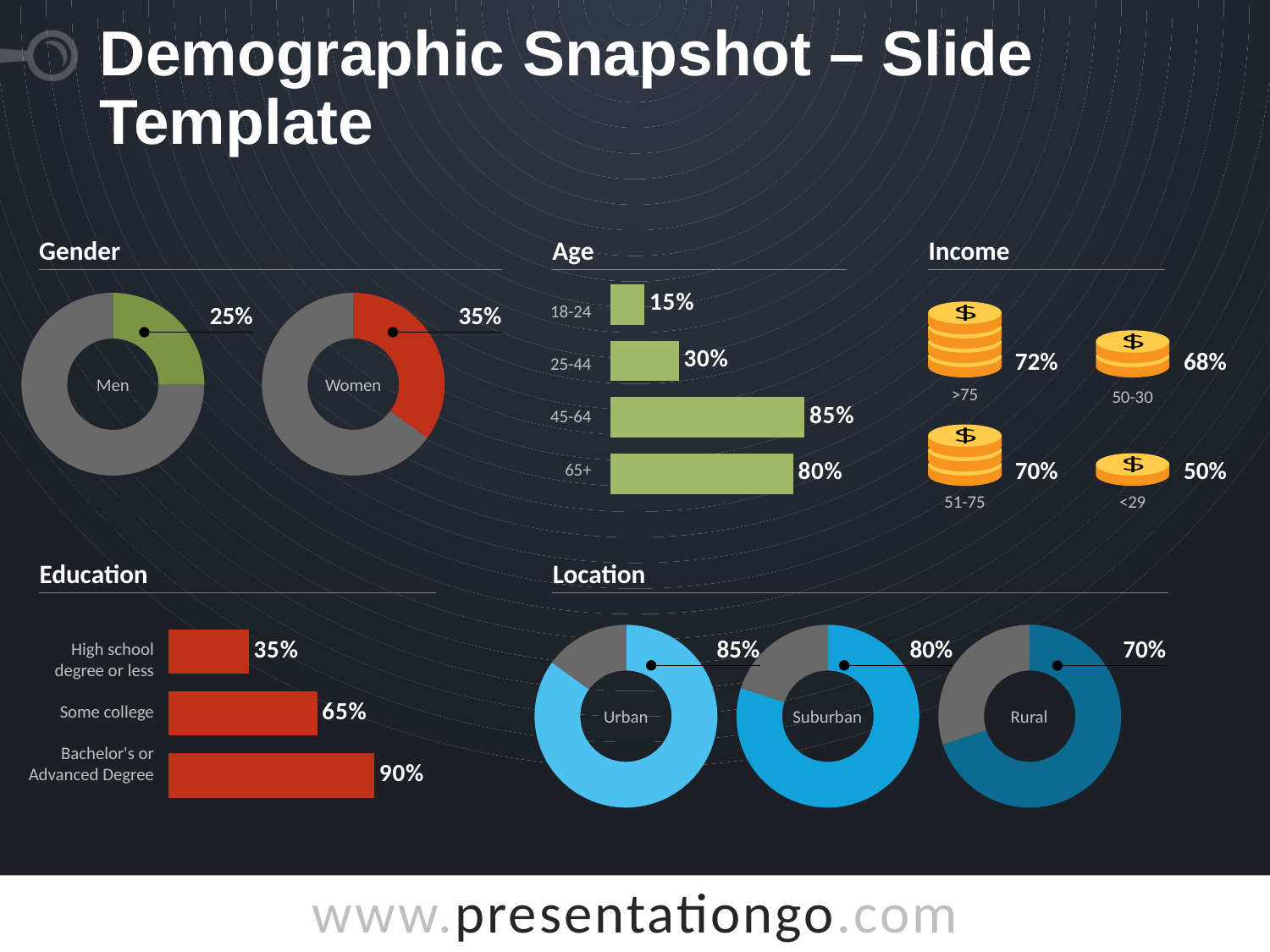
In the Education chart, what is the value for Some college? 65% In the Gender chart, what percentage is shown for Women? 35% In the Income section, what percentage is shown for the <29 group? 50% In the Gender chart, what percentage is shown for Men? 25% In the Age chart, what is the value for the 45-64 group? 85% In the Location chart, which is larger, Urban or Rural? Urban In the Age chart, which age group has the lowest value? 18-24 In the Education chart, which category has the highest value? Bachelor's or Advanced Degree In the Age chart, how many age groups are plotted? 4 In the Age chart, what is the difference between the 65+ and 25-44 values? 50% In the Location chart, what percentage is shown for Suburban? 80% What kind of chart is the Education chart? bar chart